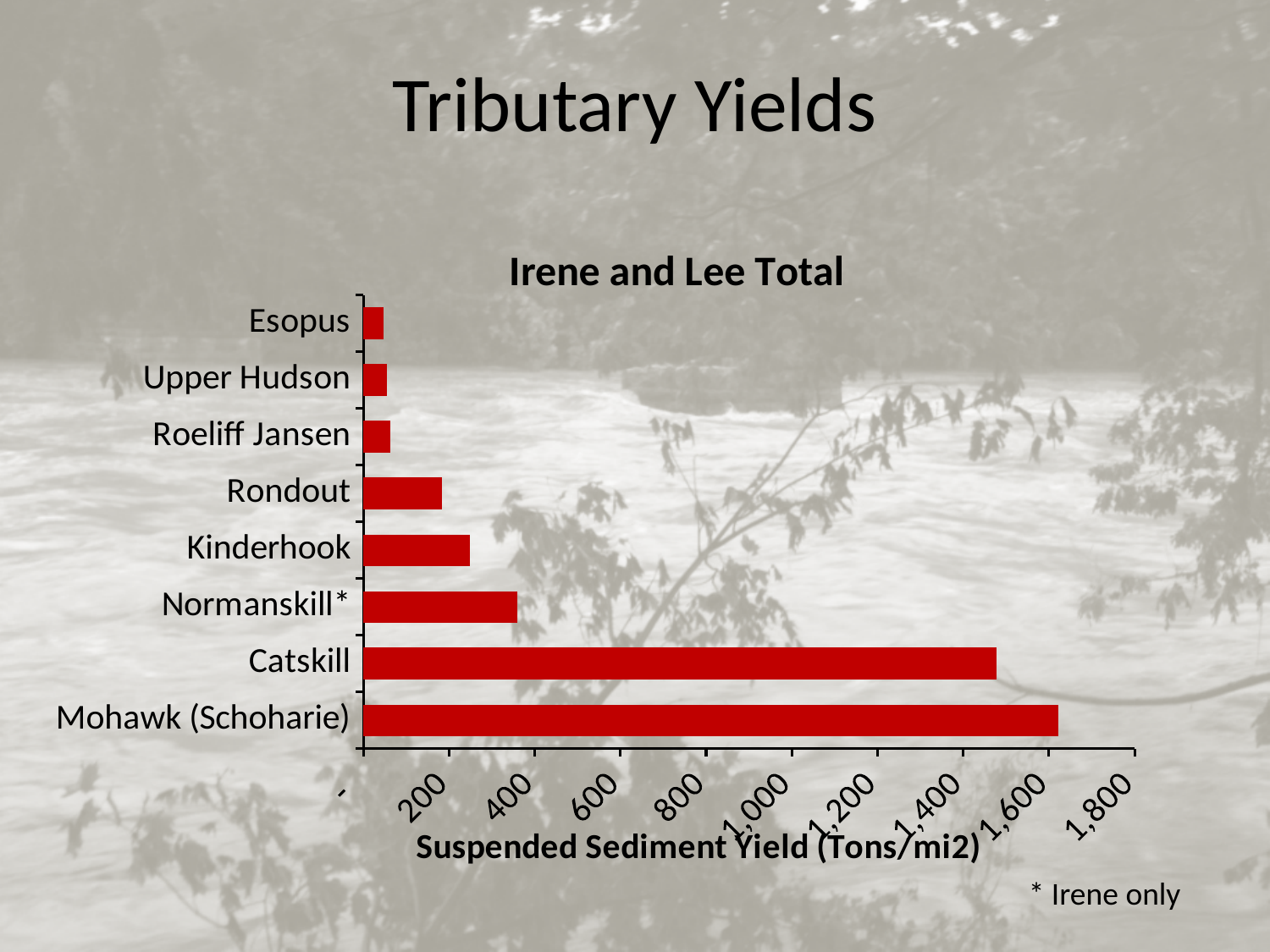
How many tributaries are plotted in the chart? 8 Which tributary has the highest suspended sediment yield? Mohawk (Schoharie) Is the value for Normanskill* greater or less than 400? less What is the title of the chart? Irene and Lee Total Which has the larger suspended sediment yield, Kinderhook or Rondout? Kinderhook Is the value for Catskill greater or less than 1,400? greater Which has the larger suspended sediment yield, Normanskill* or Kinderhook? Normanskill* What kind of chart is shown on the slide? bar chart What is the label of the horizontal axis? Suspended Sediment Yield (Tons/mi2) Which has the larger suspended sediment yield, Catskill or Mohawk (Schoharie)? Mohawk (Schoharie)